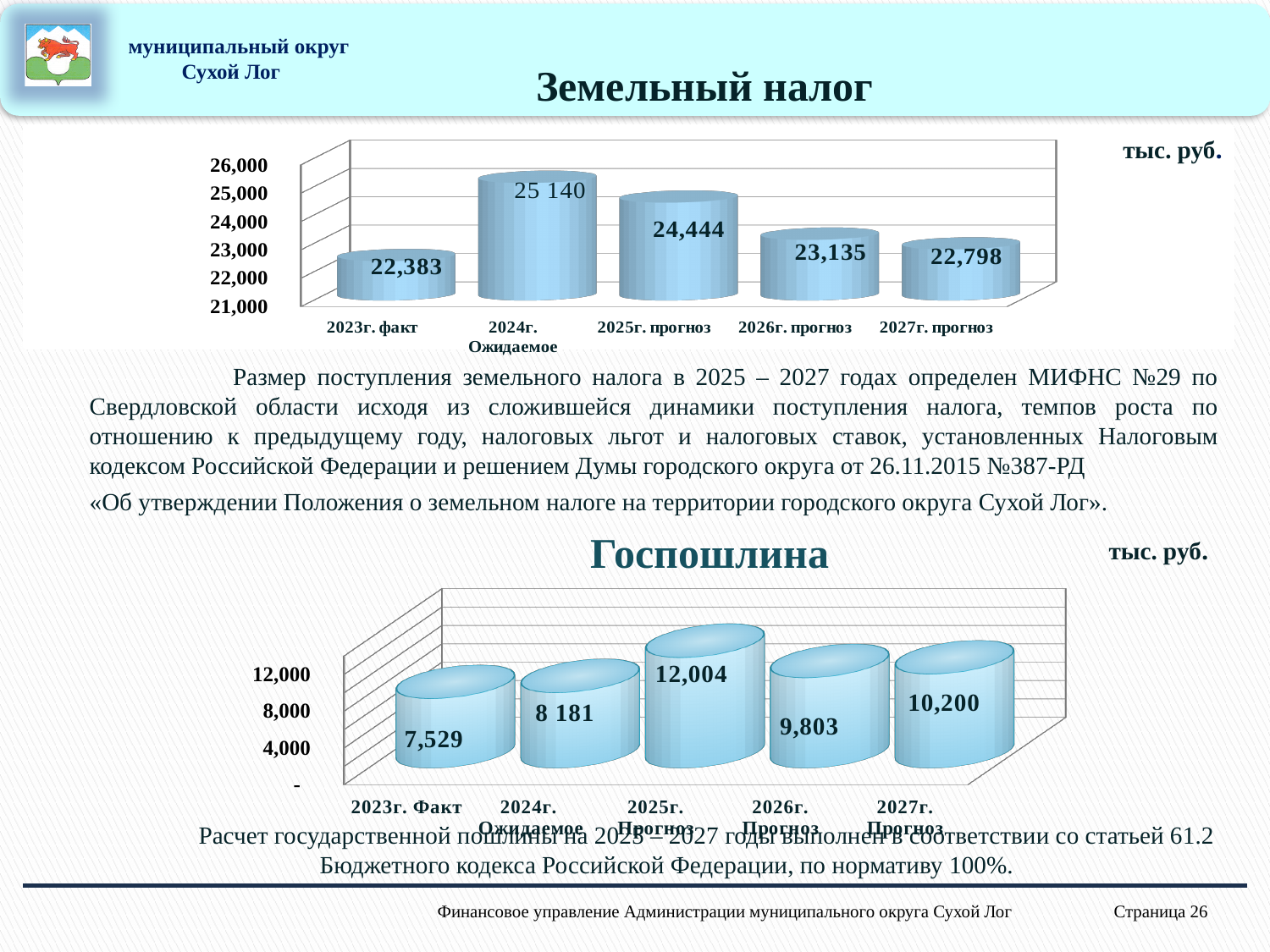
In the Госпошлина chart, what is the value for 2024г. Ожидаемое? 8 181 In the Госпошлина chart, what is the value for 2026г. Прогноз? 9,803 In the Земельный налог chart, what is the value for 2023г. факт? 22,383 In the Земельный налог chart, what is the difference between the values for 2026г. прогноз and 2027г. прогноз? 337 What kind of chart is the Госпошлина chart? Bar chart In the Земельный налог chart, how many categories are plotted? 5 In the Госпошлина chart, which is larger, the value for 2027г. Прогноз or the value for 2026г. Прогноз? 2027г. Прогноз In the Госпошлина chart, what is the difference between the values for 2025г. Прогноз and 2023г. Факт? 4,475 In the Госпошлина chart, which category has the highest value? 2025г. Прогноз In the Земельный налог chart, which category has the lowest value? 2023г. факт In the Земельный налог chart, what is the value for 2025г. прогноз? 24,444 In the Земельный налог chart, which category has the highest value? 2024г. Ожидаемое